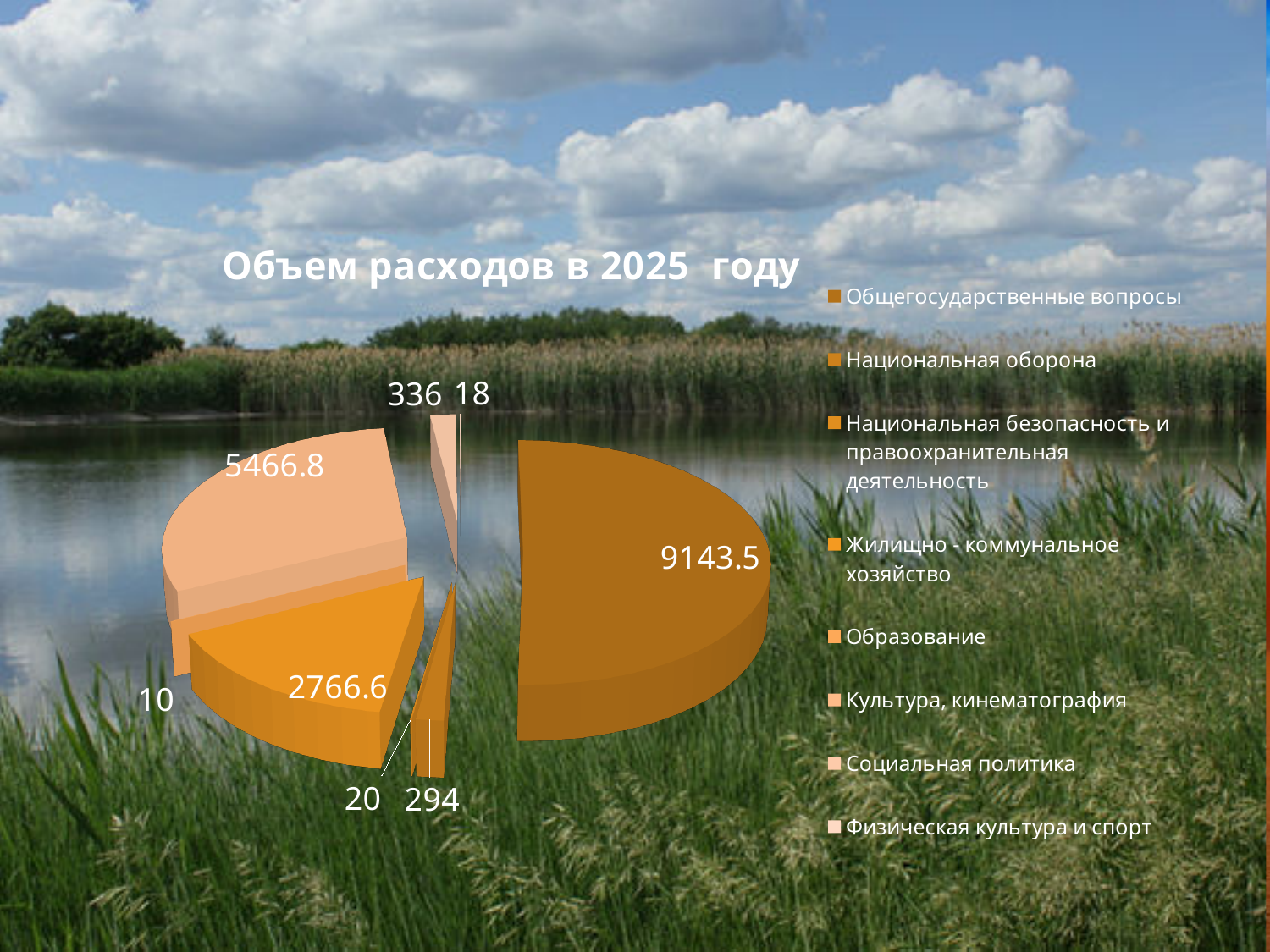
What is the smallest value labelled on the chart? 10 What is the difference between the value for Общегосударственные вопросы and the value for Культура, кинематография? 3676.7 What is the value shown for Жилищно - коммунальное хозяйство? 2766.6 What is the value shown for Культура, кинематография? 5466.8 What is the last category listed in the legend? Физическая культура и спорт Which category has the largest slice of the pie? Общегосударственные вопросы What kind of chart is shown on the slide? pie chart What is the value shown for Общегосударственные вопросы? 9143.5 What is the title of the chart? Объем расходов в 2025 году Which is larger, the value for Культура, кинематография or the value for Жилищно - коммунальное хозяйство? Культура, кинематография How many categories does the chart's legend list? 8 What is the largest value labelled on the chart? 9143.5